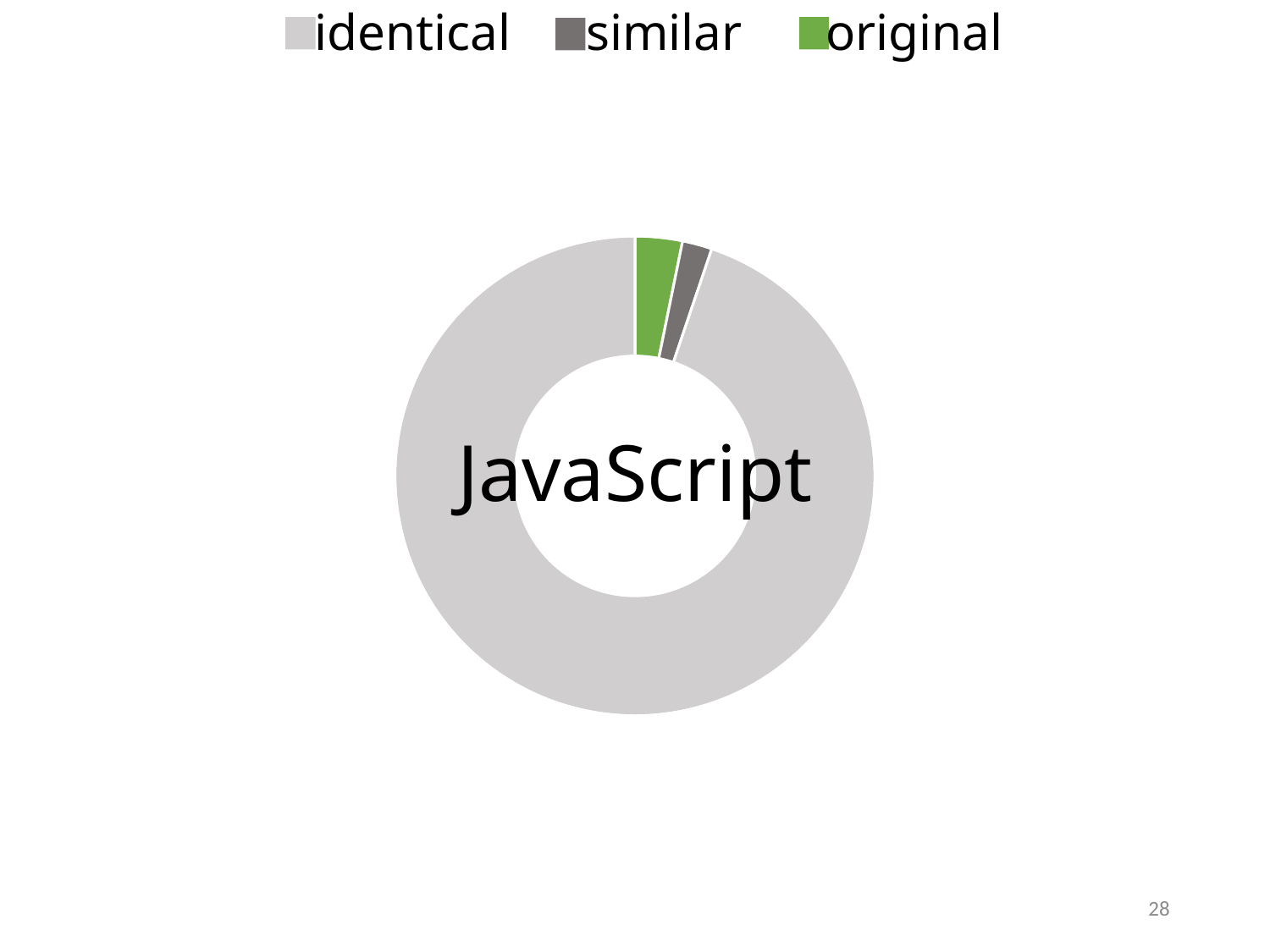
What kind of chart is shown on the slide? doughnut chart Which slice is larger, identical or original? identical Which category takes up the smallest share of the doughnut? similar How many entries does the legend list? 3 How many categories does the chart show? 3 Which slice is larger, original or similar? original Which category takes up the largest share of the doughnut? identical Which category is shown in green in the legend? original What text is shown in the centre of the doughnut chart? JavaScript